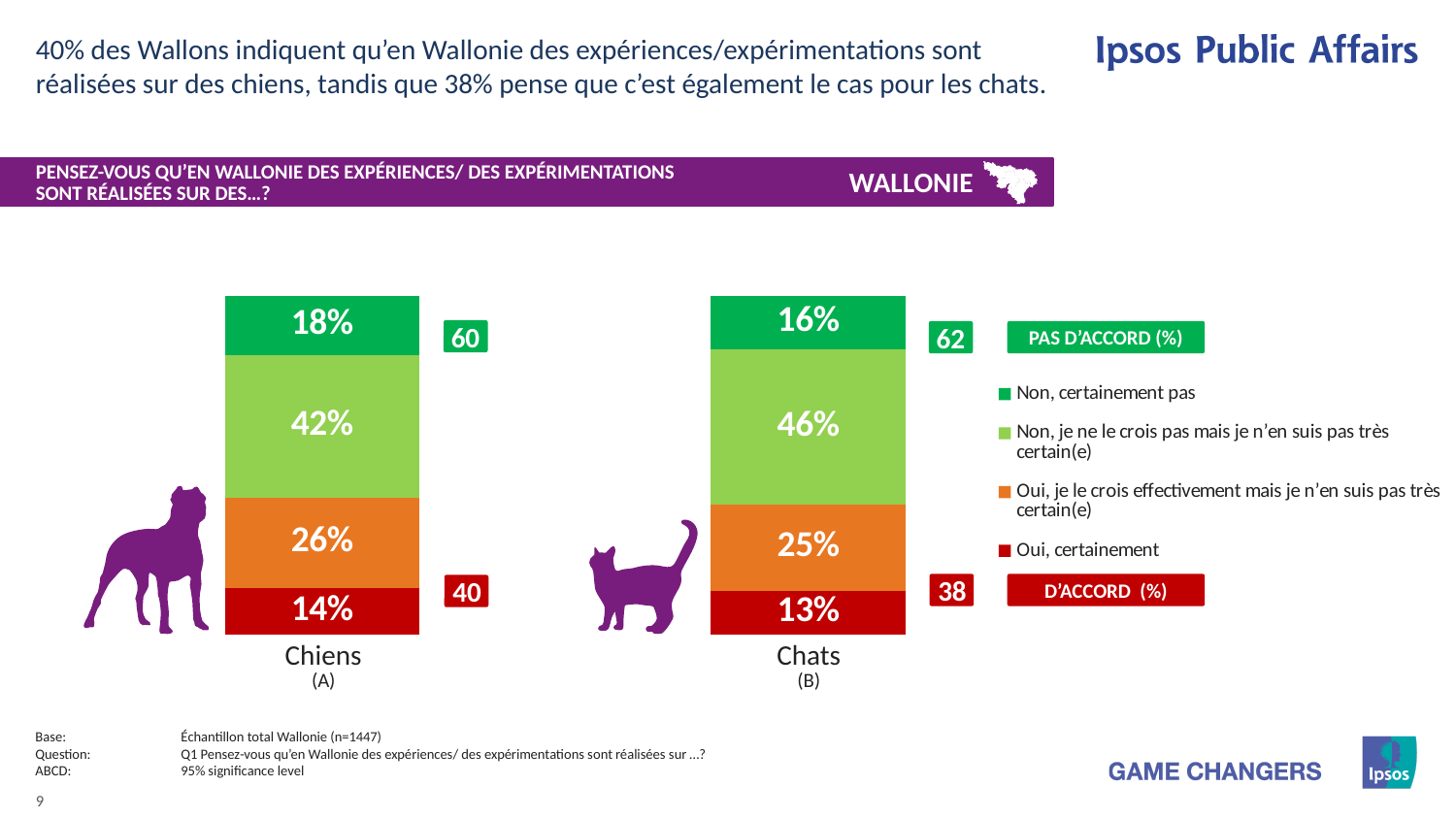
Which category has the larger "Oui, certainement" value, Chiens or Chats? Chiens What percentage of respondents answered "Non, certainement pas" for Chats? 16% Which segment is the largest within the Chiens bar? Non, je ne le crois pas mais je n'en suis pas très certain(e) What is the total "D'accord (%)" value shown for Chiens? 40 How many series does the legend list? 4 What percentage of respondents answered "Oui, certainement" for Chiens? 14% What is the value of the "Non, je ne le crois pas mais je n'en suis pas très certain(e)" segment for Chats? 46% What is the value of the "Oui, je le crois effectivement mais je n'en suis pas très certain(e)" segment for Chiens? 26% How many categories are shown on the x axis of the chart? 2 What is the total "Pas d'accord (%)" value shown for Chats? 62 What is the difference between the "Non, je ne le crois pas mais je n'en suis pas très certain(e)" values for Chats and Chiens? 4 percentage points Which segment is the smallest within the Chats bar? Oui, certainement